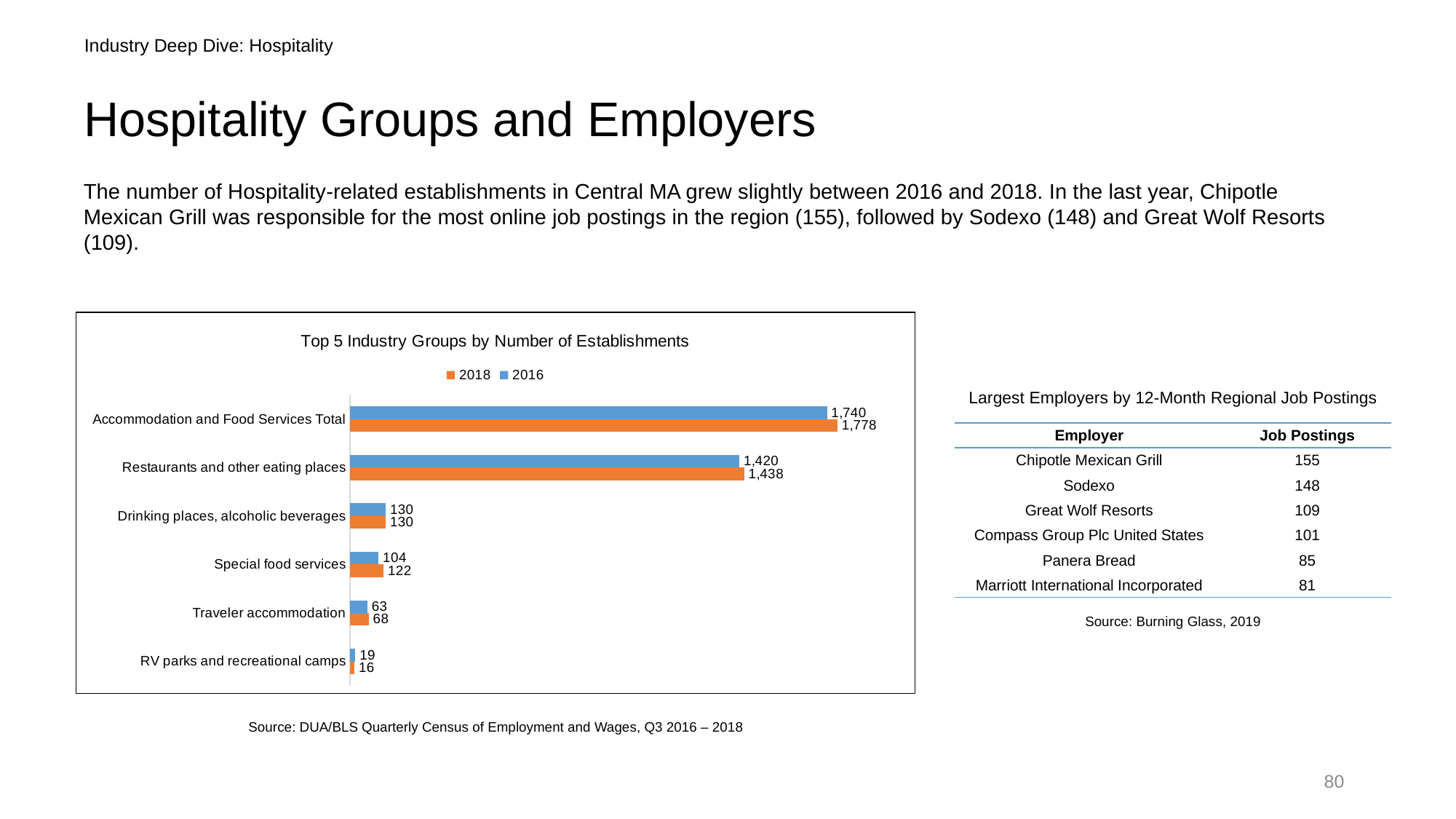
Which is larger for RV parks and recreational camps, the 2016 value or the 2018 value? 2016 What is the 2018 value for Restaurants and other eating places? 1,438 How many categories are shown on the chart's vertical axis? 6 What is the 2016 value for Special food services? 104 Which category has the lowest 2016 value? RV parks and recreational camps What is the difference between the 2018 and 2016 values for Special food services? 18 How many series does the legend of the chart list? 2 What is the difference between the 2018 and 2016 values for Accommodation and Food Services Total? 38 What type of chart is 'Top 5 Industry Groups by Number of Establishments'? Bar chart Which colour represents the 2018 series in the chart? Orange What is the 2018 value for Traveler accommodation? 68 Which category has the highest 2018 value? Accommodation and Food Services Total